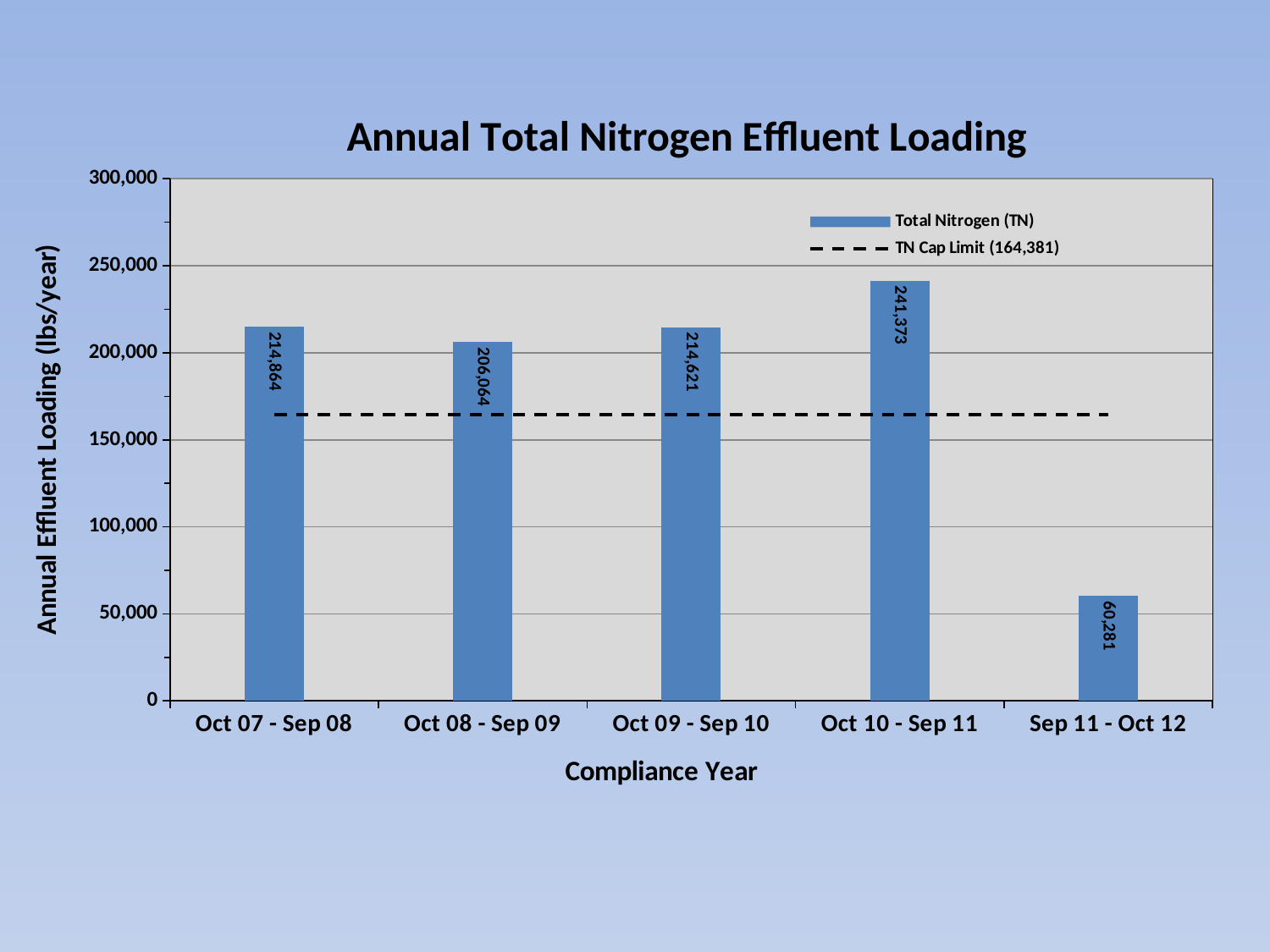
What is the TN Cap Limit shown in the legend? 164,381 What is the Total Nitrogen value for Sep 11 - Oct 12? 60,281 Which is larger, the Total Nitrogen value for Oct 07 - Sep 08 or for Oct 08 - Sep 09? Oct 07 - Sep 08 Which compliance year has the lowest Total Nitrogen loading? Sep 11 - Oct 12 What kind of chart is this? bar chart How many entries does the legend list? 2 How many compliance years are shown on the x axis? 5 What is the Total Nitrogen value for Oct 07 - Sep 08? 214,864 Which compliance year has the highest Total Nitrogen loading? Oct 10 - Sep 11 What is the difference between the Total Nitrogen values for Oct 10 - Sep 11 and Oct 08 - Sep 09? 35,309 Is the Total Nitrogen value for Sep 11 - Oct 12 greater or less than 100,000? less What is the Total Nitrogen value for Oct 10 - Sep 11? 241,373